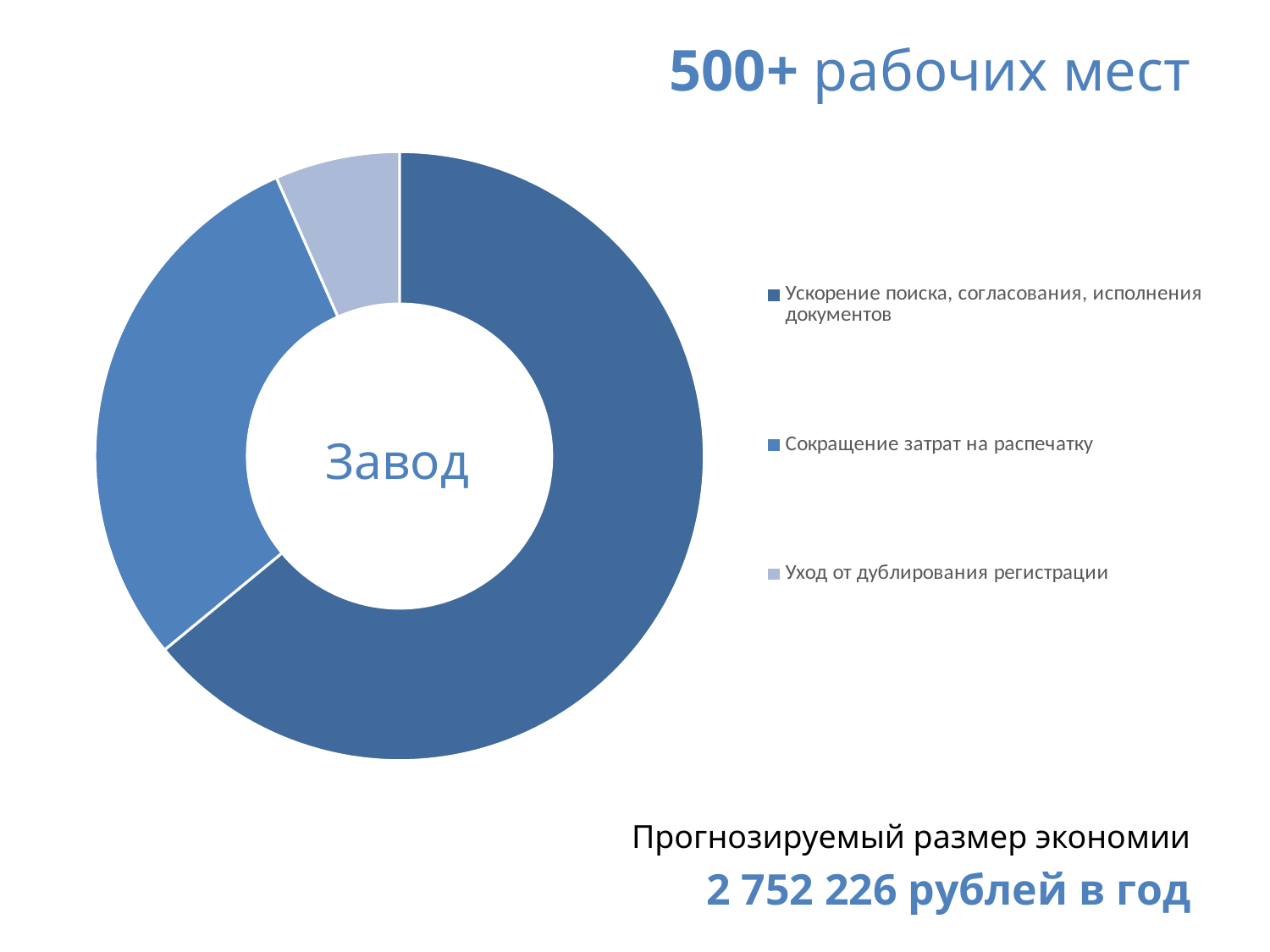
What kind of chart is shown on the slide? Doughnut (pie) chart How many slices does the doughnut chart have? 3 What text is shown in the centre of the doughnut chart? Завод Which slice is larger: "Сокращение затрат на распечатку" or "Уход от дублирования регистрации"? Сокращение затрат на распечатку How many entries does the legend list? 3 Which category has the smallest slice of the doughnut chart? Уход от дублирования регистрации Which legend entry is shown with the lightest colour? Уход от дублирования регистрации Which slice is larger: "Ускорение поиска, согласования, исполнения документов" or "Сокращение затрат на распечатку"? Ускорение поиска, согласования, исполнения документов Does the slice for "Ускорение поиска, согласования, исполнения документов" take up more or less than half of the doughnut? more Which category has the largest slice of the doughnut chart? Ускорение поиска, согласования, исполнения документов